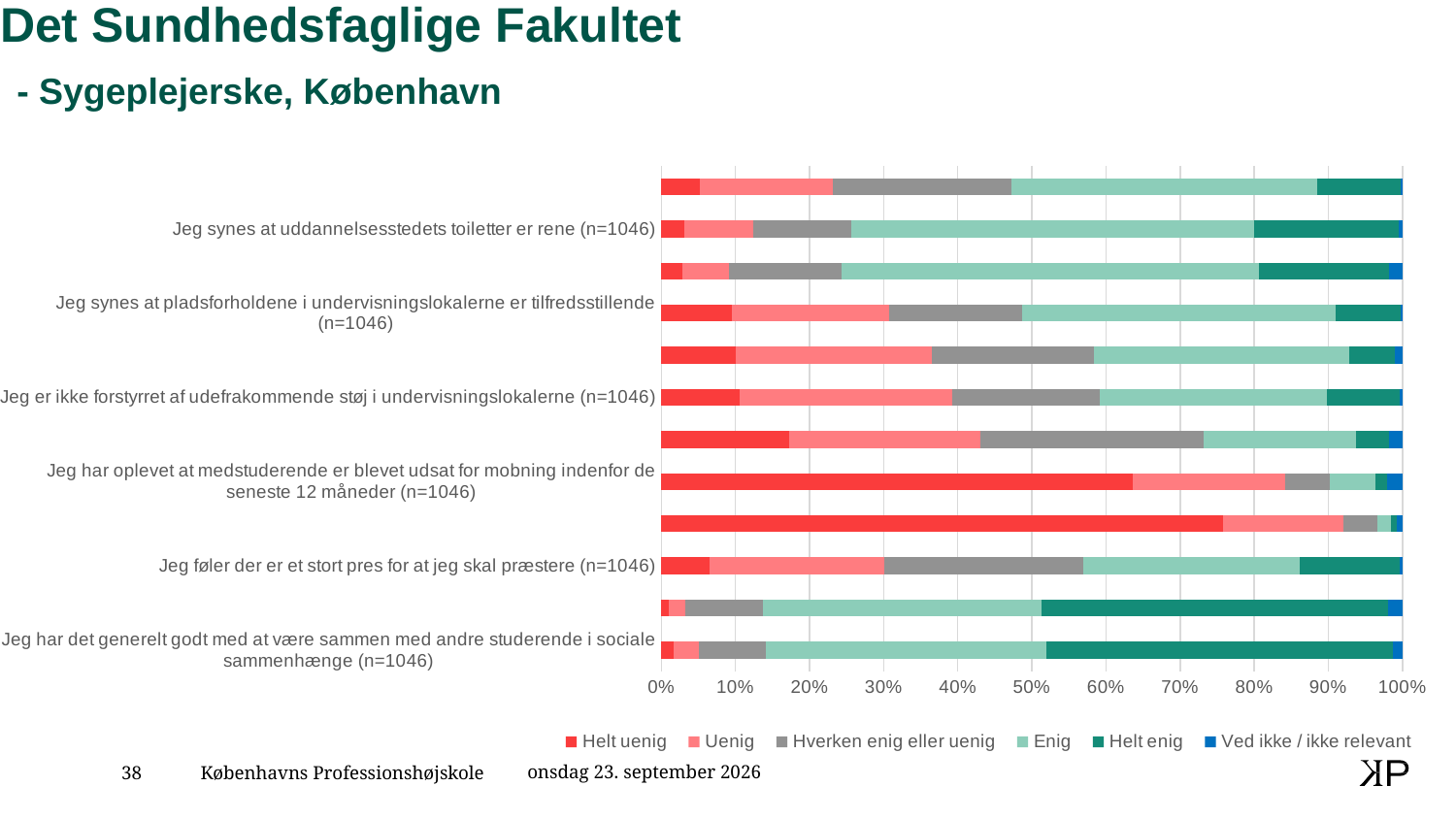
Among the labelled statements, which has the largest 'Helt enig' share? Jeg har det generelt godt med at være sammen med andre studerende i sociale sammenhænge (n=1046) Is the 'Helt uenig' share for 'Jeg har oplevet at medstuderende er blevet udsat for mobning indenfor de seneste 12 måneder (n=1046)' greater or less than 50%? greater Is the 'Helt uenig' share for 'Jeg føler der er et stort pres for at jeg skal præstere (n=1046)' greater or less than 10%? less Which has the larger 'Helt uenig' share: 'Jeg har oplevet at medstuderende er blevet udsat for mobning indenfor de seneste 12 måneder (n=1046)' or 'Jeg synes at uddannelsesstedets toiletter er rene (n=1046)'? Jeg har oplevet at medstuderende er blevet udsat for mobning indenfor de seneste 12 måneder (n=1046) Is the 'Helt enig' share for 'Jeg har det generelt godt med at være sammen med andre studerende i sociale sammenhænge (n=1046)' greater or less than 40%? greater What kind of chart is shown on the slide? Stacked bar chart Among the labelled statements, which has the smallest 'Helt enig' share? Jeg har oplevet at medstuderende er blevet udsat for mobning indenfor de seneste 12 måneder (n=1046) How many series does the legend list? 6 What is the maximum value shown on the horizontal axis? 100% What is the first entry in the chart legend? Helt uenig How many stacked bars are plotted in the chart? 12